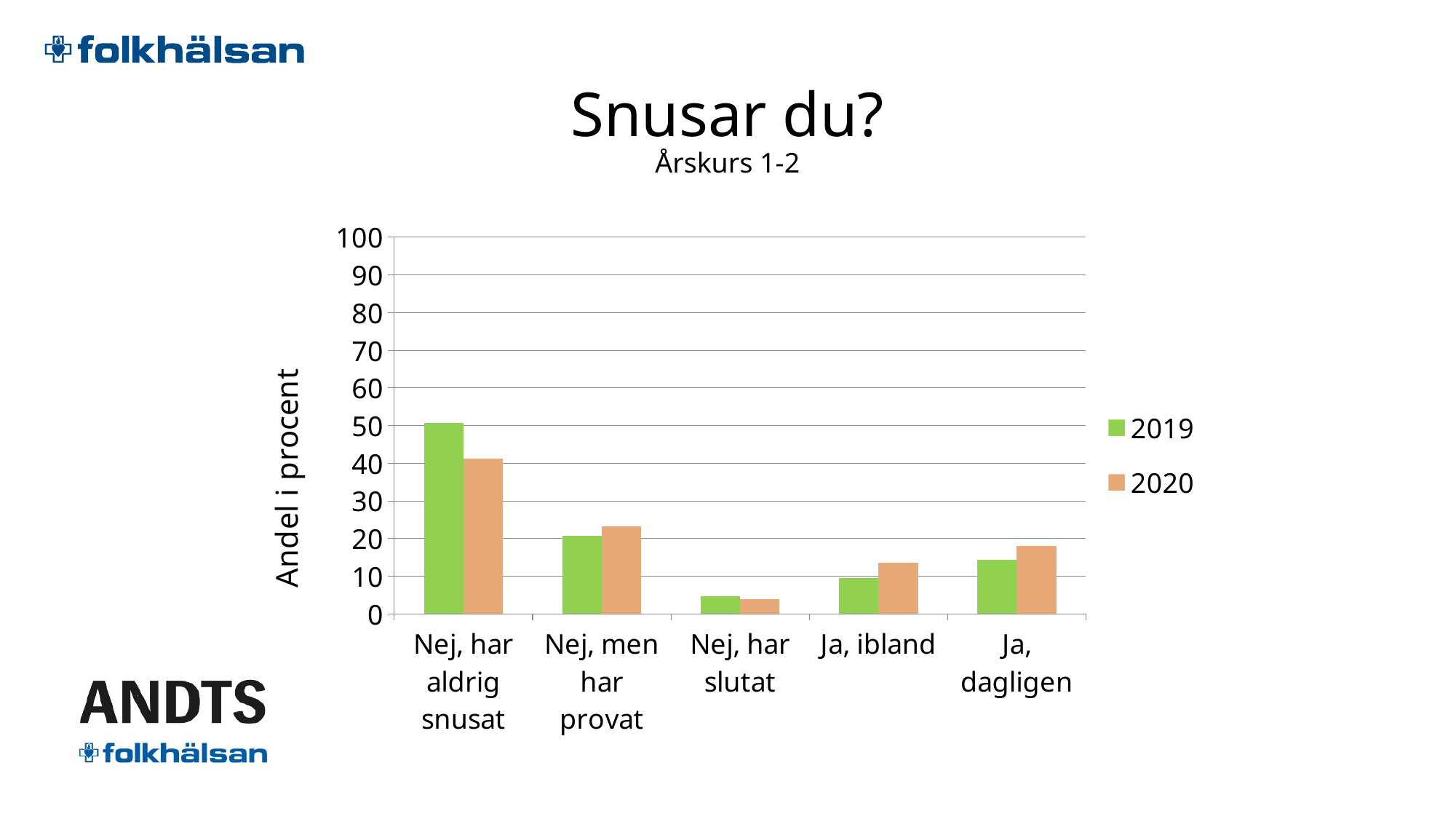
What is the label of the y axis? Andel i procent Is the 2020 value for 'Ja, dagligen' greater or less than 10? greater Is the 2020 value for 'Nej, har aldrig snusat' greater or less than 50? less Is the 2019 value for 'Nej, har aldrig snusat' greater or less than 40? greater How many series does the legend list? 2 Which category has the lowest value for 2020? Nej, har slutat How many categories are shown on the x axis? 5 For 'Nej, har aldrig snusat', which year has the larger value, 2019 or 2020? 2019 Which category has the highest value for 2019? Nej, har aldrig snusat What kind of chart is shown on the slide? bar chart For 'Ja, ibland', which year has the larger value, 2019 or 2020? 2020